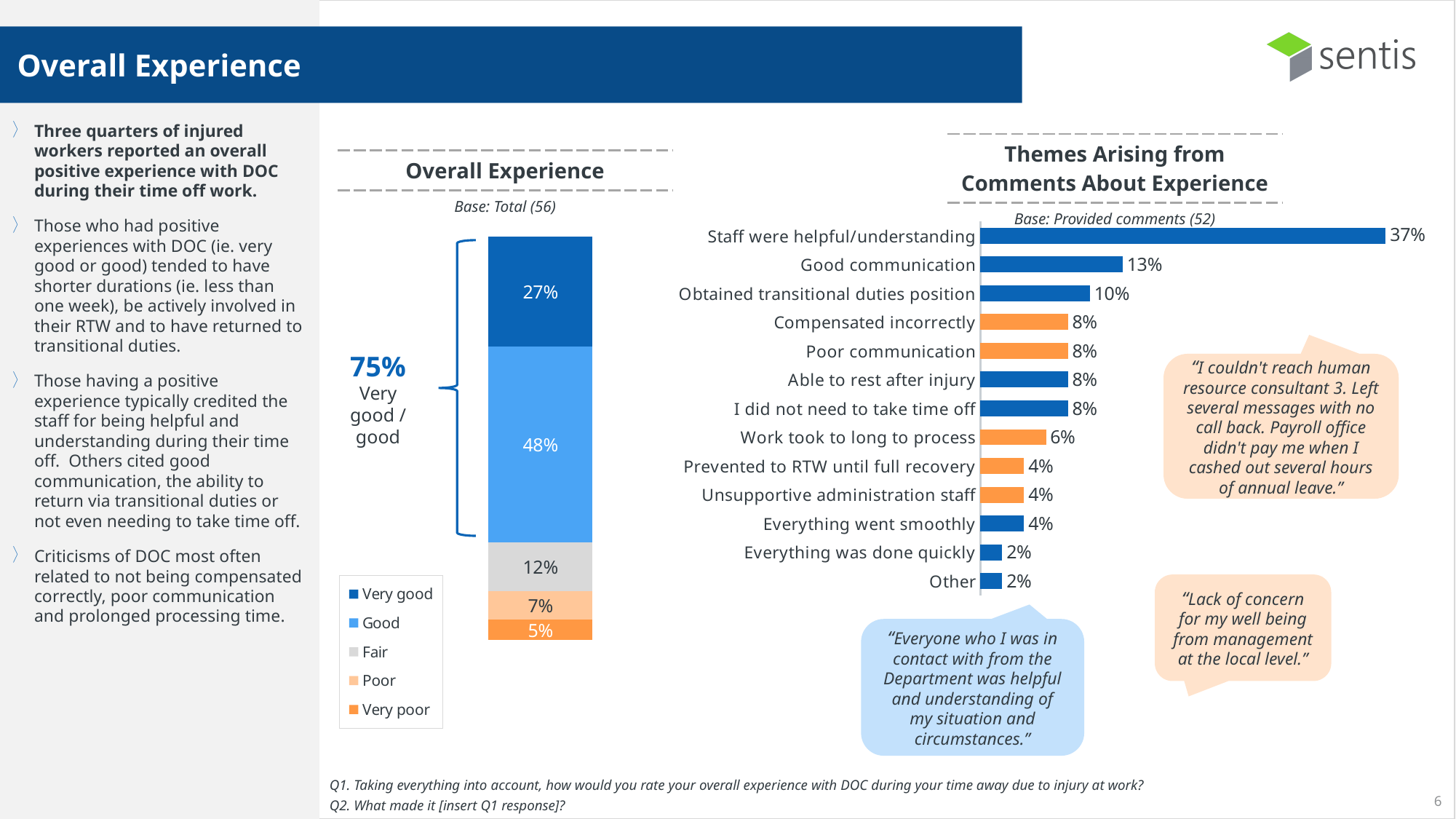
In the Themes Arising from Comments About Experience chart, what is the value for Good communication? 13% In the Themes Arising from Comments About Experience chart, what is the value for Work took to long to process? 6% In the Overall Experience chart, what percentage of respondents rated their experience as Good? 48% In the Overall Experience chart, what is the combined percentage for Very good and Good? 75% In the Overall Experience chart, how many series does the legend list? 5 In the Themes Arising from Comments About Experience chart, how many themes are listed? 13 In the Themes Arising from Comments About Experience chart, what is the difference between Staff were helpful/understanding and Good communication? 24% In the Overall Experience chart, what is the difference between the Fair and Poor percentages? 5% In the Themes Arising from Comments About Experience chart, which is larger: Obtained transitional duties position or Compensated incorrectly? Obtained transitional duties position In the Themes Arising from Comments About Experience chart, which theme has the highest percentage? Staff were helpful/understanding In the Overall Experience chart, what percentage rated their experience as Very poor? 5% What kind of chart is the Themes Arising from Comments About Experience chart? Bar chart